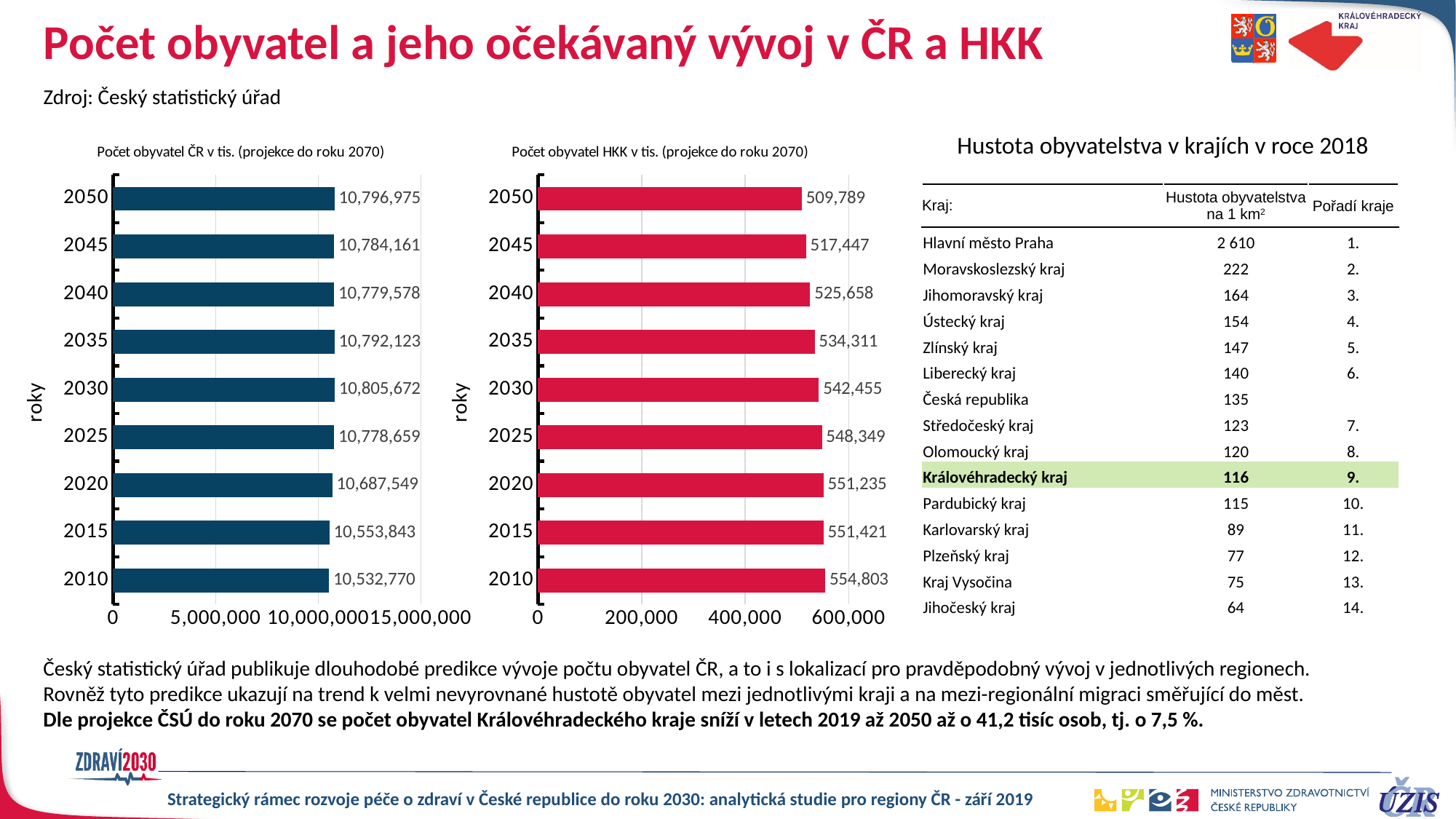
In the chart 'Počet obyvatel ČR v tis. (projekce do roku 2070)', which year has the lowest value? 2010 In the chart 'Počet obyvatel HKK v tis. (projekce do roku 2070)', which is larger, the value for 2020 or the value for 2040? 2020 In the chart 'Počet obyvatel HKK v tis. (projekce do roku 2070)', is the value for 2030 greater or less than 400,000? greater In the chart 'Počet obyvatel HKK v tis. (projekce do roku 2070)', do the values rise or fall from 2010 to 2050? fall In the chart 'Počet obyvatel HKK v tis. (projekce do roku 2070)', which year has the lowest value? 2050 In the chart 'Počet obyvatel HKK v tis. (projekce do roku 2070)', what is the value for 2050? 509,789 In the chart 'Počet obyvatel ČR v tis. (projekce do roku 2070)', which year has the highest value? 2030 In the chart 'Počet obyvatel ČR v tis. (projekce do roku 2070)', what is the difference between the values for 2050 and 2010? 264,205 In the chart 'Počet obyvatel HKK v tis. (projekce do roku 2070)', what is the difference between the values for 2010 and 2050? 45,014 In the chart 'Počet obyvatel ČR v tis. (projekce do roku 2070)', what is the value for 2030? 10,805,672 How many years (bars) are shown in the chart 'Počet obyvatel ČR v tis. (projekce do roku 2070)'? 9 In the chart 'Počet obyvatel HKK v tis. (projekce do roku 2070)', what is the value for 2010? 554,803